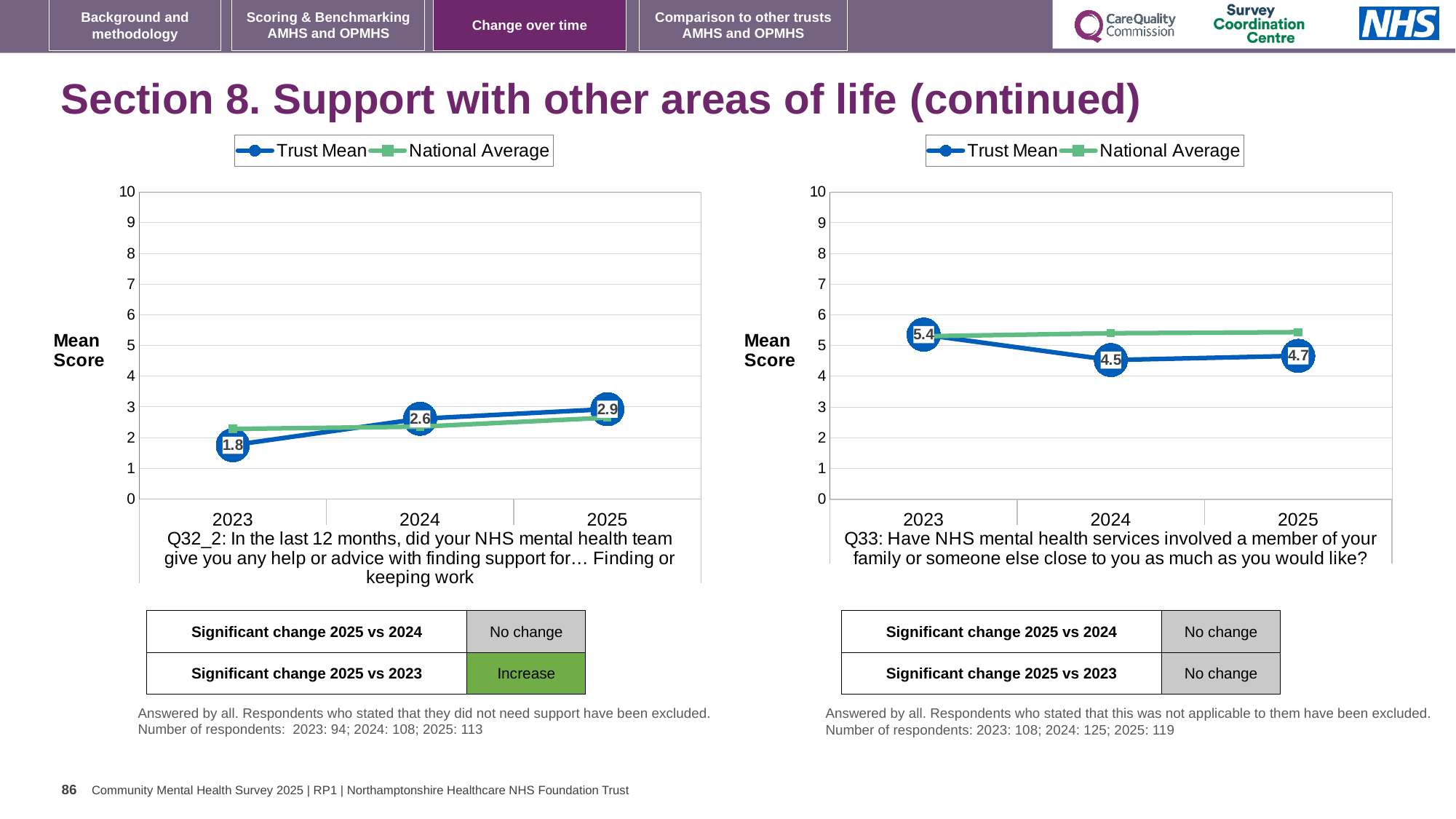
In the left chart (Q32_2), does the Trust Mean rise or fall from 2023 to 2025? rise In the left chart (Q32_2), what is the Trust Mean for 2023? 1.8 In the left chart (Q32_2), what is the difference between the Trust Mean for 2025 and 2023? 1.1 In the right chart (Q33), which year has the lowest Trust Mean? 2024 In the right chart (Q33), is the National Average for 2024 greater or less than 5? greater In the right chart (Q33), what is the Trust Mean for 2024? 4.5 In the left chart (Q32_2), what is the Trust Mean for 2025? 2.9 What kind of chart is the left chart (Q32_2)? line chart How many series does the legend of the right chart (Q33) list? 2 In the left chart (Q32_2), which year has the highest Trust Mean? 2025 In the right chart (Q33), which is larger, the Trust Mean for 2023 or for 2025? 2023 In the right chart (Q33), what is the Trust Mean for 2023? 5.4